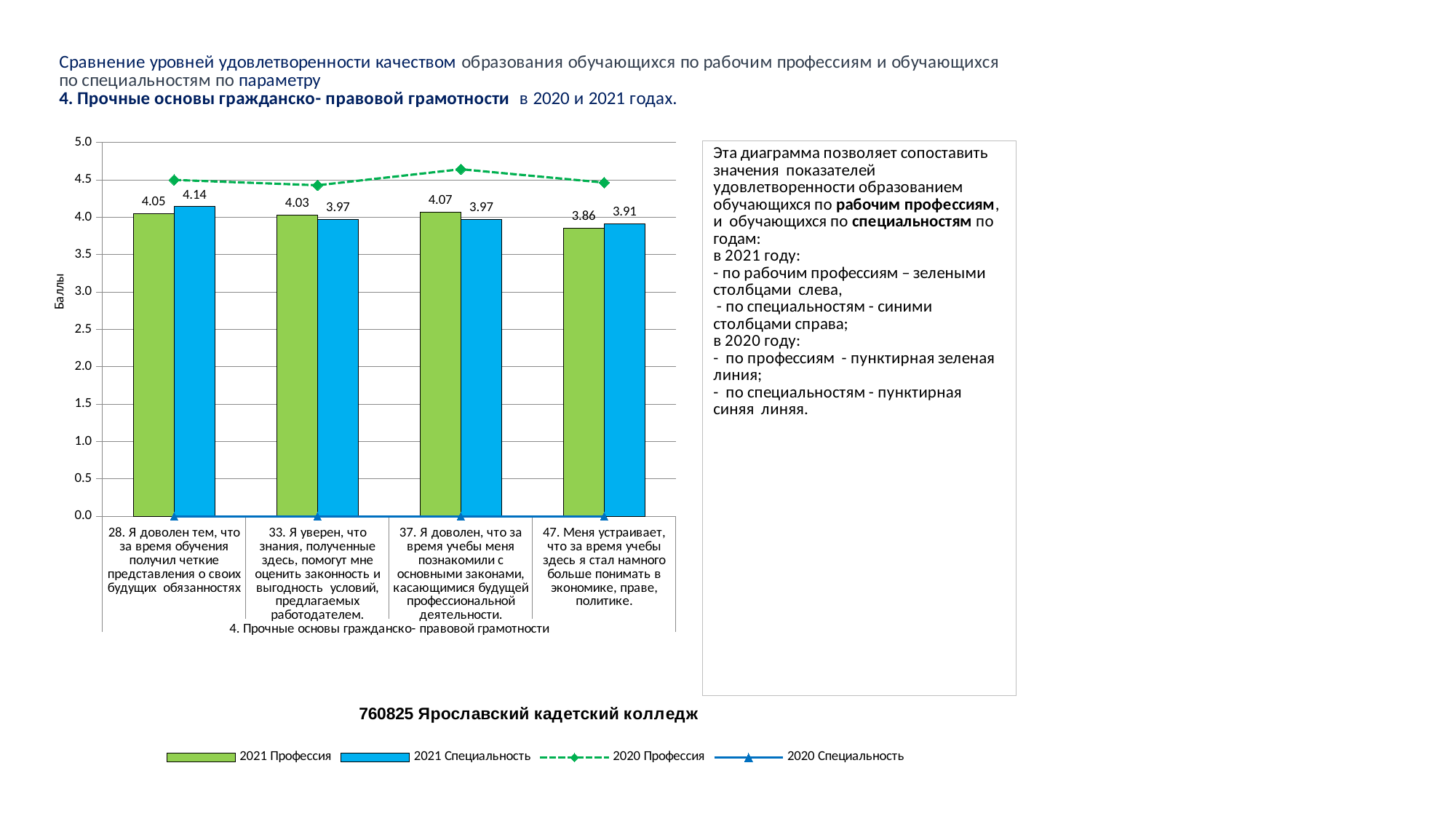
What is the label of the vertical axis? Баллы Which item has the lowest 2021 Профессия value? 47. Меня устраивает, что за время учебы здесь я стал намного больше понимать в экономике, праве, политике. Is the 2020 Профессия value for item 37 greater or less than 4.5? greater How many survey items (categories) are shown on the x axis? 4 What is the value of the 2021 Профессия bar for item 28 (Я доволен тем, что за время обучения получил четкие представления о своих будущих обязанностях)? 4.05 For item 28, what is the difference between the 2021 Специальность value and the 2021 Профессия value? 0.09 What kind of chart is shown on the slide? Combined bar and line chart How many series does the legend list? 4 What is the value of the 2021 Специальность bar for item 33? 3.97 Which item has the highest 2021 Профессия value? 37. Я доволен, что за время учебы меня познакомили с основными законами, касающимися будущей профессиональной деятельности. What is the value of the 2021 Специальность bar for item 47 (Меня устраивает, что за время учебы здесь я стал намного больше понимать в экономике, праве, политике)? 3.91 For item 33, which is larger: the 2021 Профессия value or the 2021 Специальность value? 2021 Профессия